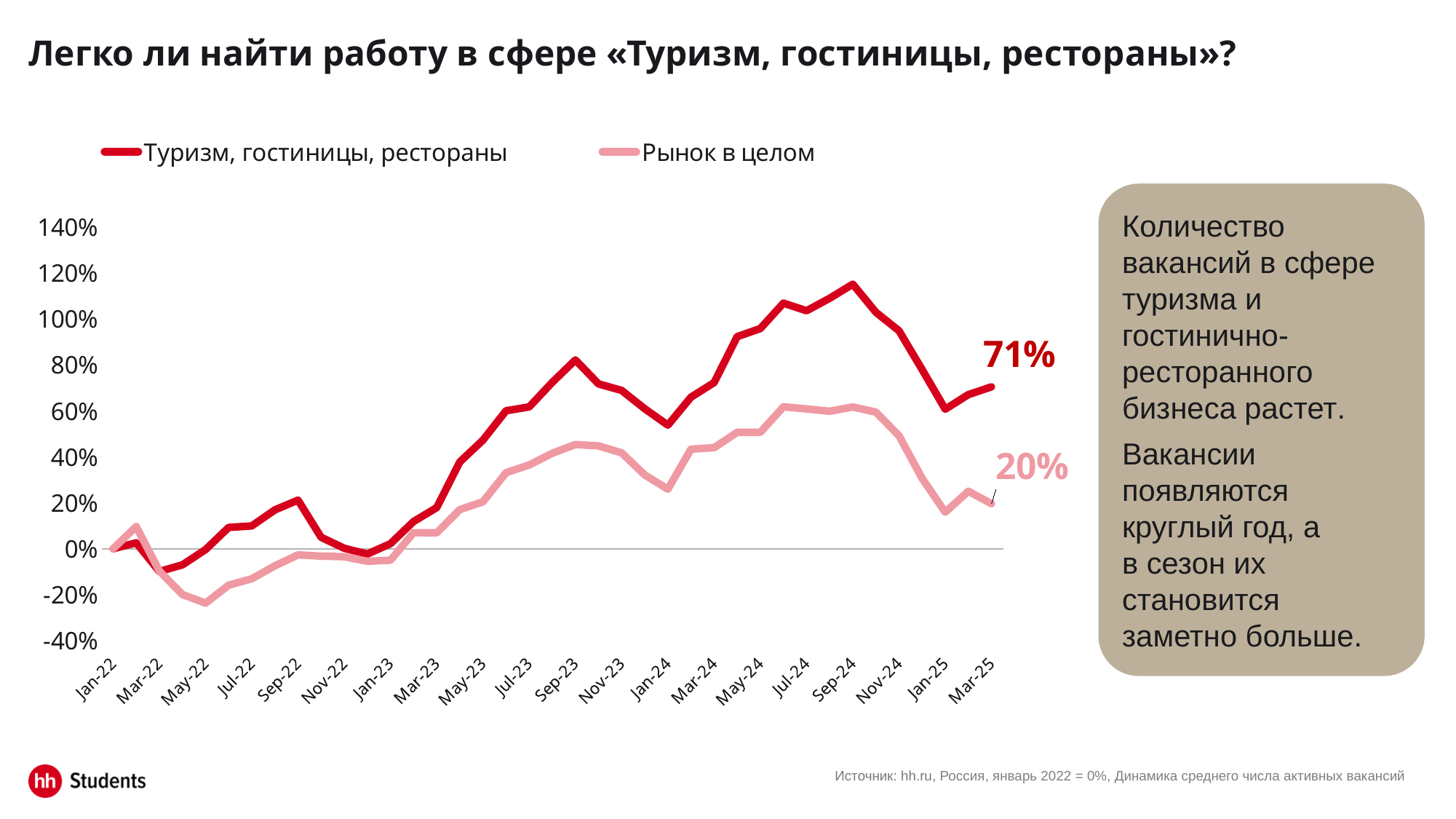
What is the difference between the «Туризм, гостиницы, рестораны» and «Рынок в целом» values at Mar-25? 51 percentage points At Mar-25, which series has the higher value: «Туризм, гостиницы, рестораны» or «Рынок в целом»? Туризм, гостиницы, рестораны Is the value for «Рынок в целом» at May-22 greater or less than 0%? less What kind of chart is shown on the slide? line chart What is the value of the «Туризм, гостиницы, рестораны» series at Mar-25? 71% Overall, does the «Туризм, гостиницы, рестораны» series rise or fall from Jan-22 to Mar-25? rise What is the value of the «Рынок в целом» series at Mar-25? 20% In which month does the «Туризм, гостиницы, рестораны» series reach its highest value? Sep-24 Is the value for «Рынок в целом» at Jul-24 greater or less than 40%? greater Which series is drawn in the darker red line? Туризм, гостиницы, рестораны Is the value for «Туризм, гостиницы, рестораны» at Sep-24 greater or less than 100%? greater How many series does the legend list? 2